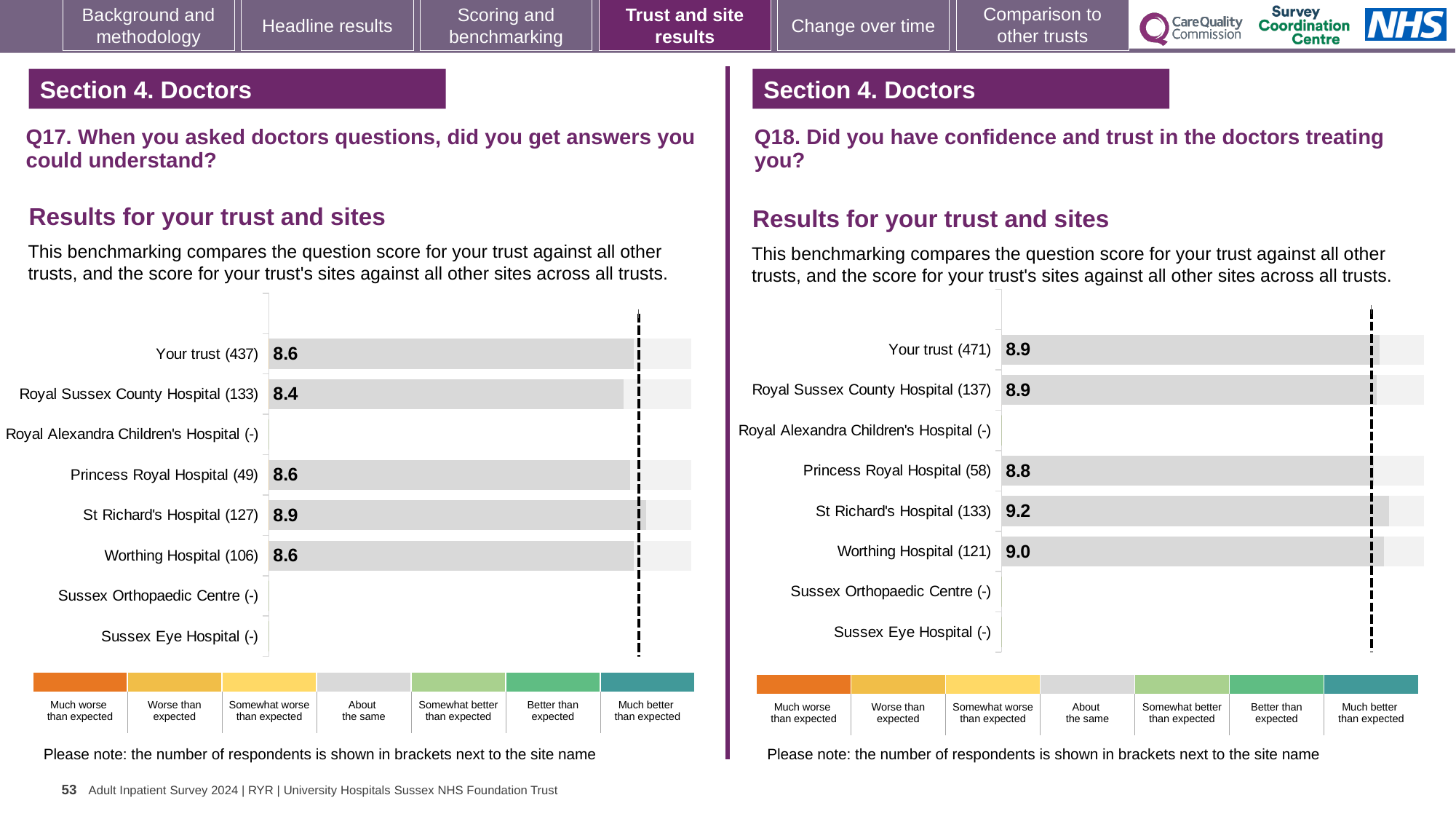
On the Q18 chart (right), what is the score for St Richard's Hospital (133)? 9.2 On the Q17 chart (left), which site has the highest score? St Richard's Hospital (127) On the Q18 chart (right), which is larger: the score for St Richard's Hospital or the score for Princess Royal Hospital? St Richard's Hospital On the Q18 chart (right), what is the score for Worthing Hospital (121)? 9.0 On the Q18 chart (right), which site has the lowest score? Princess Royal Hospital (58) On the Q17 chart (left), what is the score for Your trust (437)? 8.6 On the Q17 chart (left), what is the difference between the scores for St Richard's Hospital and Royal Sussex County Hospital? 0.5 On the Q17 chart (left), what is the score for Royal Sussex County Hospital (133)? 8.4 On the Q17 chart (left), how many sites have a score bar plotted? 4 What kind of chart is used on the Q18 chart (right)? Bar chart On the Q17 chart (left), which site has the lowest score? Royal Sussex County Hospital (133) On the Q18 chart (right), what is the difference between the scores for St Richard's Hospital and Your trust? 0.3